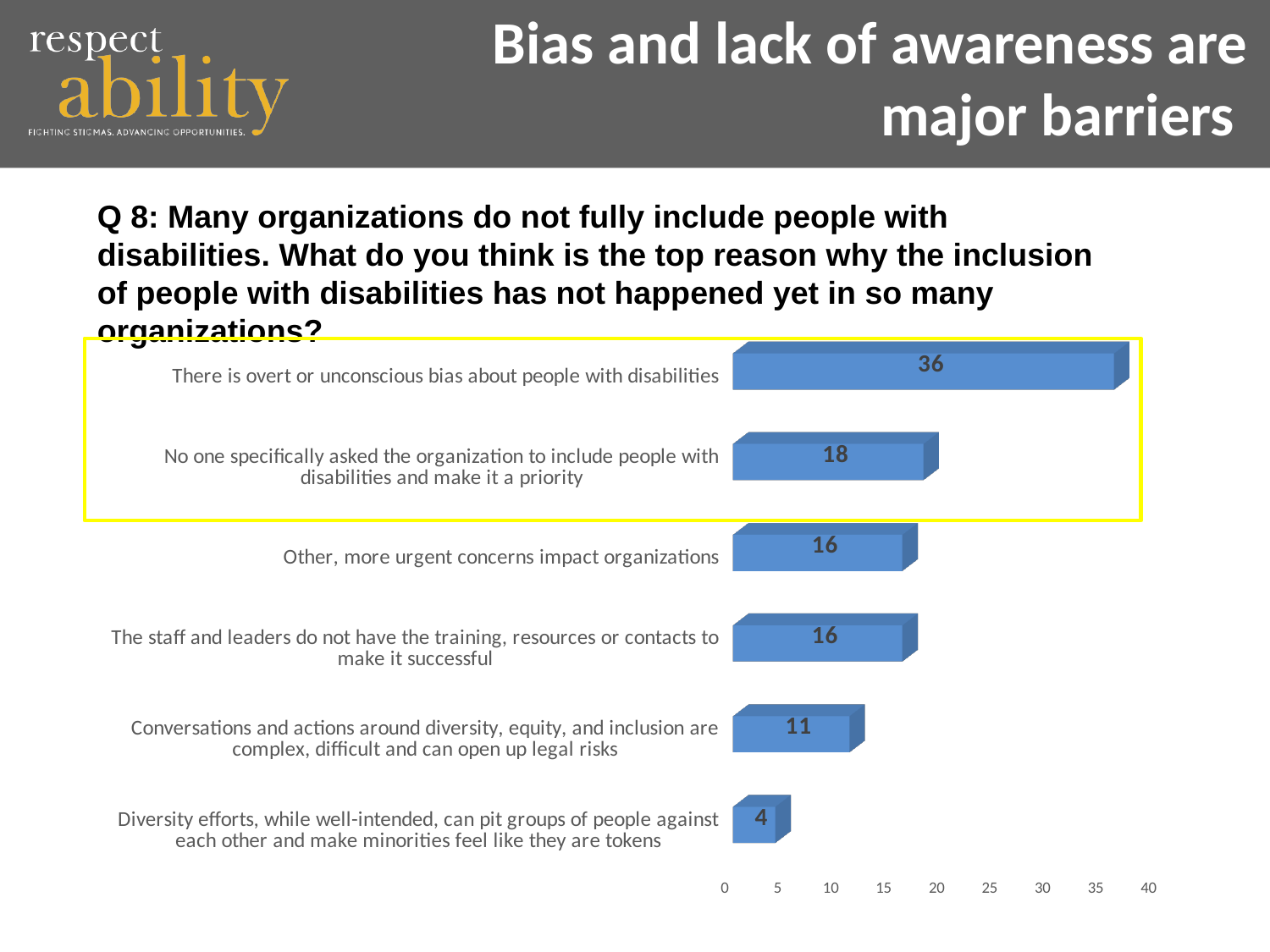
Which category has the highest value? There is overt or unconscious bias about people with disabilities What is the value for "The staff and leaders do not have the training, resources or contacts to make it successful"? 16 What is the value for "No one specifically asked the organization to include people with disabilities and make it a priority"? 18 Which is larger: the value for "Other, more urgent concerns impact organizations" or the value for "Conversations and actions around diversity, equity, and inclusion are complex, difficult and can open up legal risks"? Other, more urgent concerns impact organizations What is the difference between the value for "There is overt or unconscious bias about people with disabilities" and the value for "No one specifically asked the organization to include people with disabilities and make it a priority"? 18 Which category has the lowest value? Diversity efforts, while well-intended, can pit groups of people against each other and make minorities feel like they are tokens Is the value for "There is overt or unconscious bias about people with disabilities" greater or less than 30? greater What is the value for "There is overt or unconscious bias about people with disabilities"? 36 How many categories are shown in the chart? 6 What is the value for "Conversations and actions around diversity, equity, and inclusion are complex, difficult and can open up legal risks"? 11 What kind of chart is shown on the slide? bar chart What is the value for "Diversity efforts, while well-intended, can pit groups of people against each other and make minorities feel like they are tokens"? 4